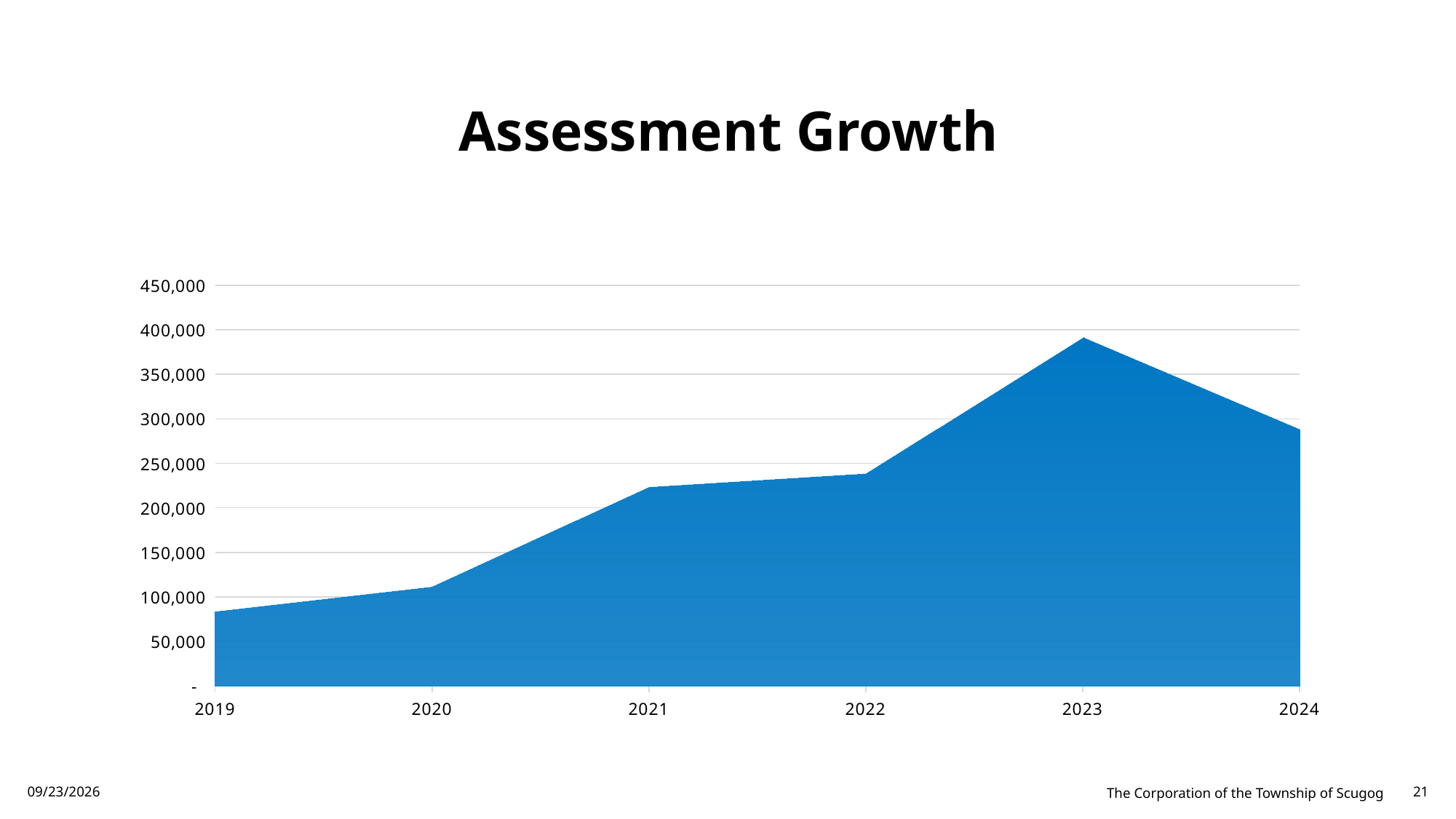
Which year has the highest assessment growth value? 2023 What kind of chart is shown on the slide? area chart Does the value rise or fall from 2023 to 2024? fall What is the title of the chart? Assessment Growth How many years are plotted along the x axis? 6 Which year has the larger value, 2020 or 2021? 2021 Is the value for 2021 greater or less than 200,000? greater Is the value for 2023 greater or less than 350,000? greater Is the value for 2024 greater or less than 300,000? less Which year has the larger value, 2022 or 2024? 2024 Which year has the lowest assessment growth value? 2019